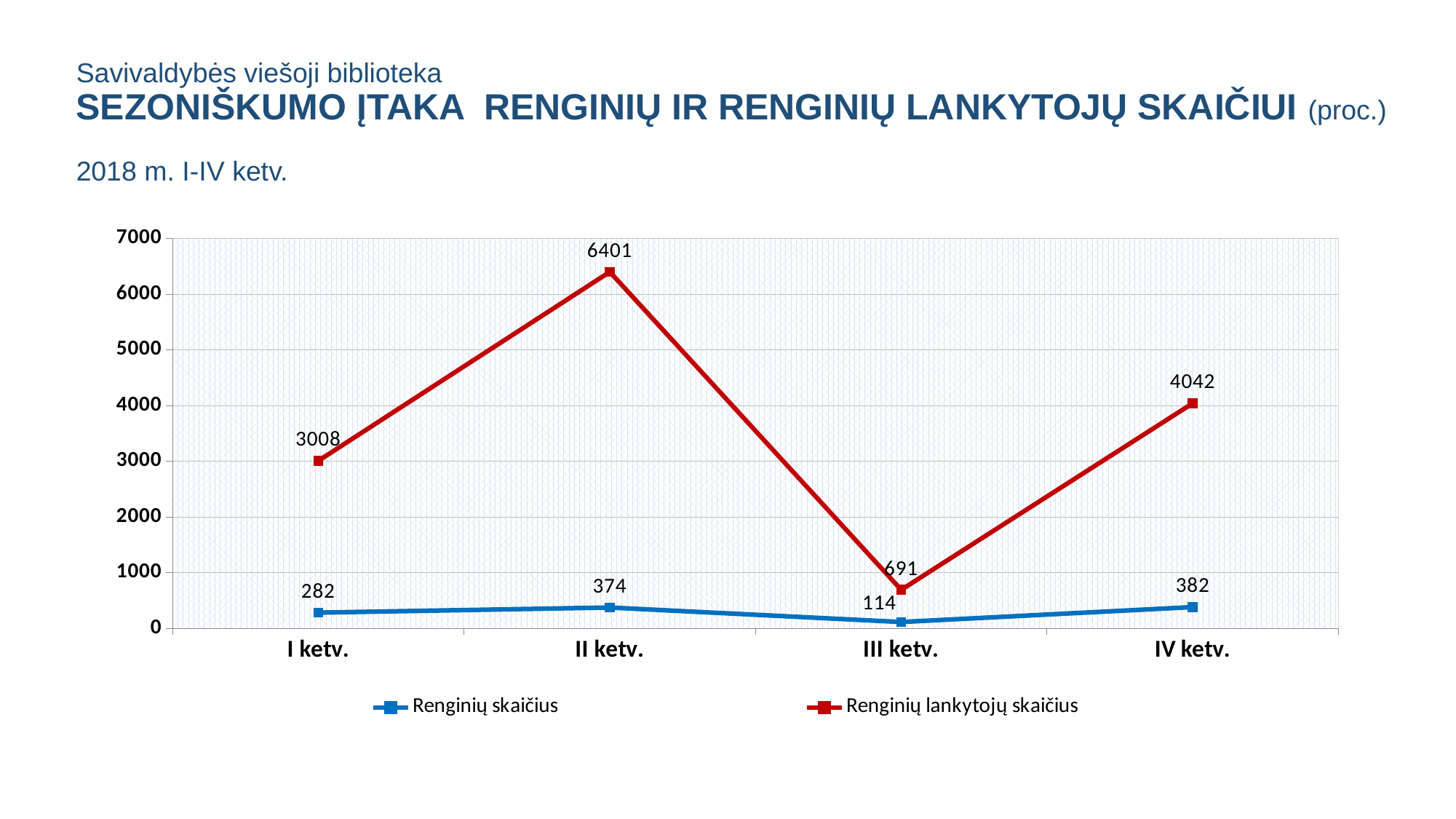
What is the value of Renginių lankytojų skaičius for II ketv.? 6401 What is the value of Renginių skaičius for III ketv.? 114 What is the difference between Renginių skaičius in IV ketv. and I ketv.? 100 What is the value of Renginių lankytojų skaičius for IV ketv.? 4042 What is the difference between Renginių lankytojų skaičius in II ketv. and III ketv.? 5710 Is the value of Renginių lankytojų skaičius for III ketv. greater or less than 1000? less How many quarters are shown on the x axis? 4 What kind of chart is shown on the slide? line chart In which quarter is Renginių lankytojų skaičius highest? II ketv. Which is larger: Renginių lankytojų skaičius in I ketv. or in IV ketv.? IV ketv. In which quarter is Renginių skaičius lowest? III ketv. How many series does the legend list? 2